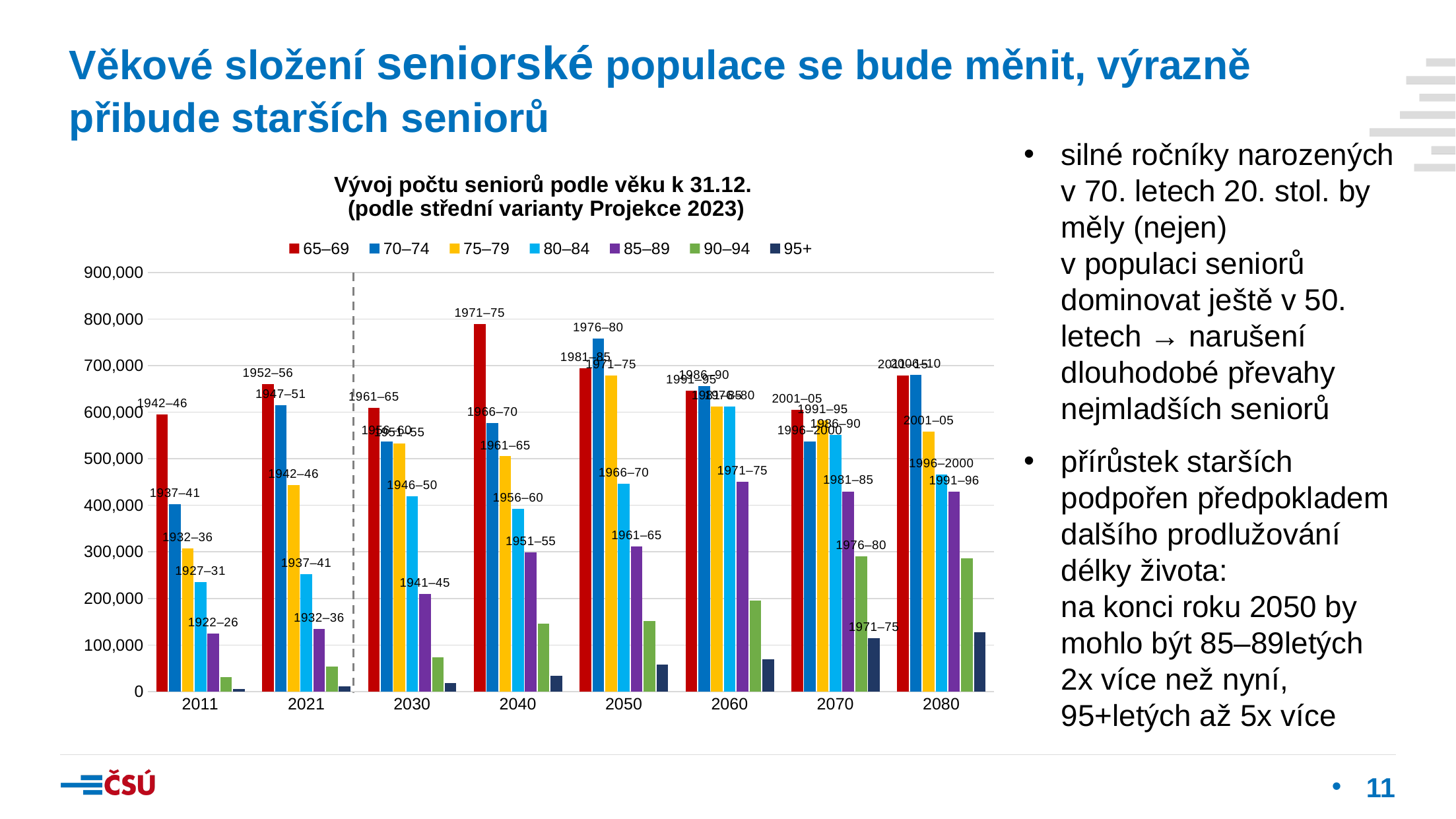
Is the value for the 65–69 age group in 2040 greater or less than 700,000? greater Which is larger: the 70–74 bar in 2011 or the 70–74 bar in 2021? 2021 How many series does the legend of the chart list? 7 Is the value for the 95+ age group in 2080 greater or less than 200,000? less In 2050, which is larger: the 65–69 bar or the 70–74 bar? 70–74 Do the values for the 95+ age group rise or fall from 2011 to 2080? rise How many years are shown on the x axis of the chart? 8 Is the value for the 90–94 age group in 2070 greater or less than 200,000? greater In which year is the bar for the 95+ age group the lowest? 2011 What kind of chart is shown on the slide? bar chart In which year is the bar for the 65–69 age group the highest? 2040